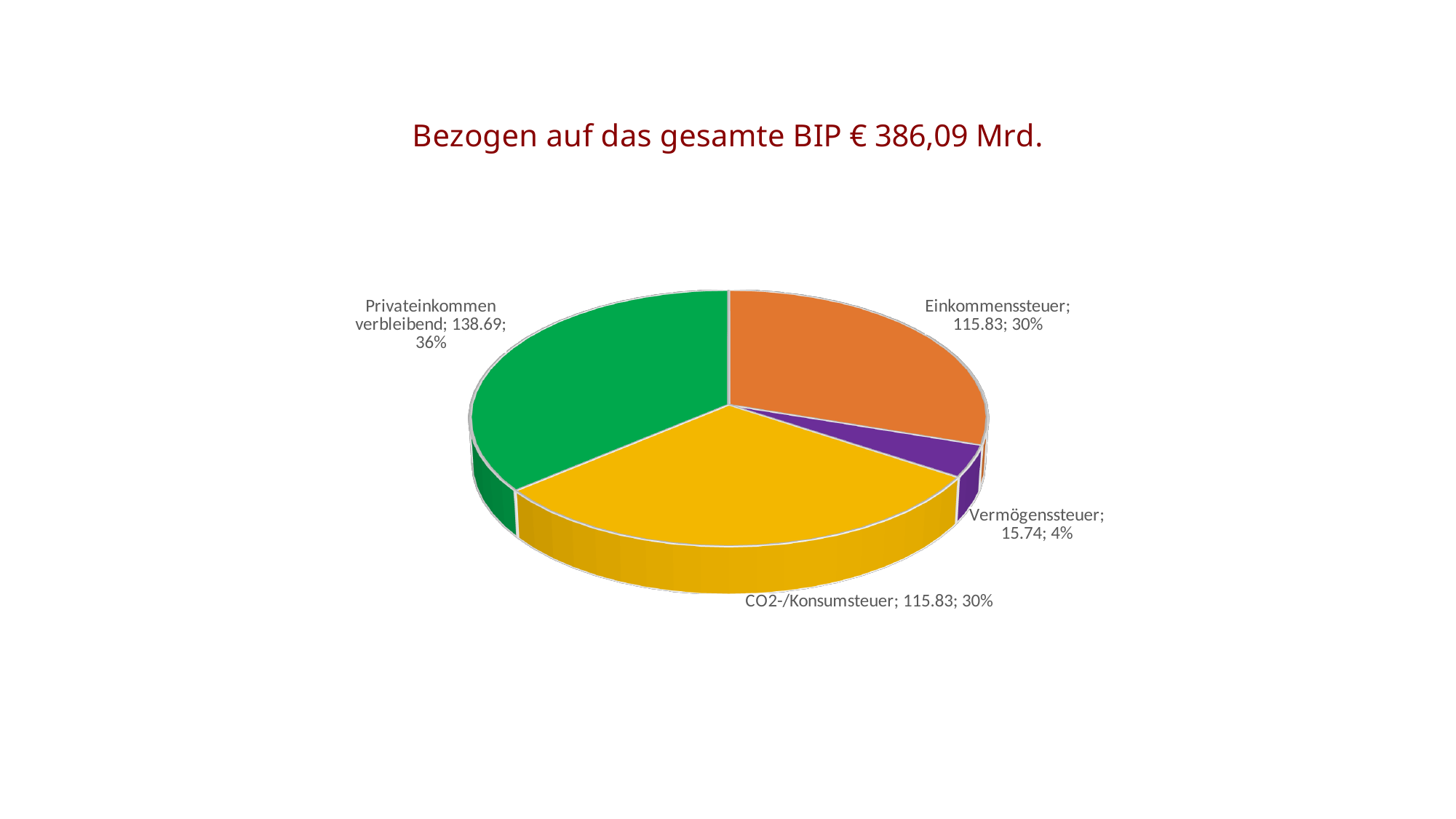
What share of the pie does CO2-/Konsumsteuer represent? 30% What share of the pie does Privateinkommen verbleibend represent? 36% What is the value for Privateinkommen verbleibend? 138.69 Which colour is the Vermögenssteuer slice? Purple How many slices does the pie chart have? 4 What is the value for Einkommenssteuer? 115.83 Which category has the smallest slice? Vermögenssteuer What is the difference between the values for Privateinkommen verbleibend and Einkommenssteuer? 22.86 Which category has the largest slice? Privateinkommen verbleibend What is the value for Vermögenssteuer? 15.74 What is the title of the chart? Bezogen auf das gesamte BIP € 386,09 Mrd. What kind of chart is shown on the slide? Pie chart